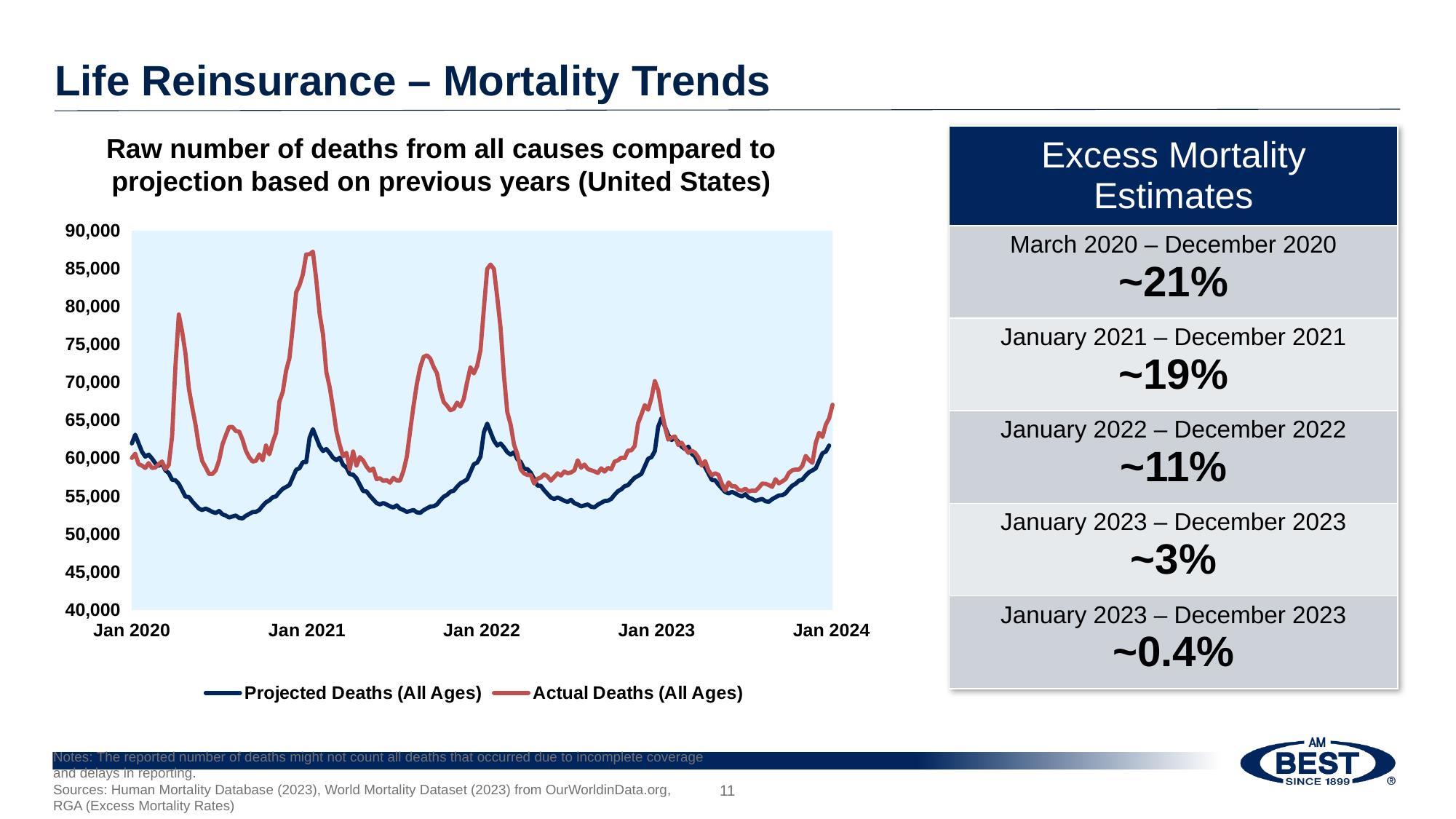
What are the two series named in the chart's legend? Projected Deaths (All Ages) and Actual Deaths (All Ages) Which series reaches the highest value on the chart? Actual Deaths (All Ages) Around January 2021, which series has the larger value: Projected Deaths (All Ages) or Actual Deaths (All Ages)? Actual Deaths (All Ages) Is the peak value of Actual Deaths (All Ages) around January 2022 greater or less than 80,000? greater What is the highest value shown on the chart's y axis? 90,000 How many series does the chart's legend list? 2 Is the peak value of Actual Deaths (All Ages) around January 2021 greater or less than 85,000? greater Is the lowest value of Projected Deaths (All Ages) during 2020 greater or less than 55,000? less How many year labels are shown on the x axis of the chart? 5 What kind of chart is shown on the slide? Line chart Which colour is used for the Actual Deaths (All Ages) line? Red